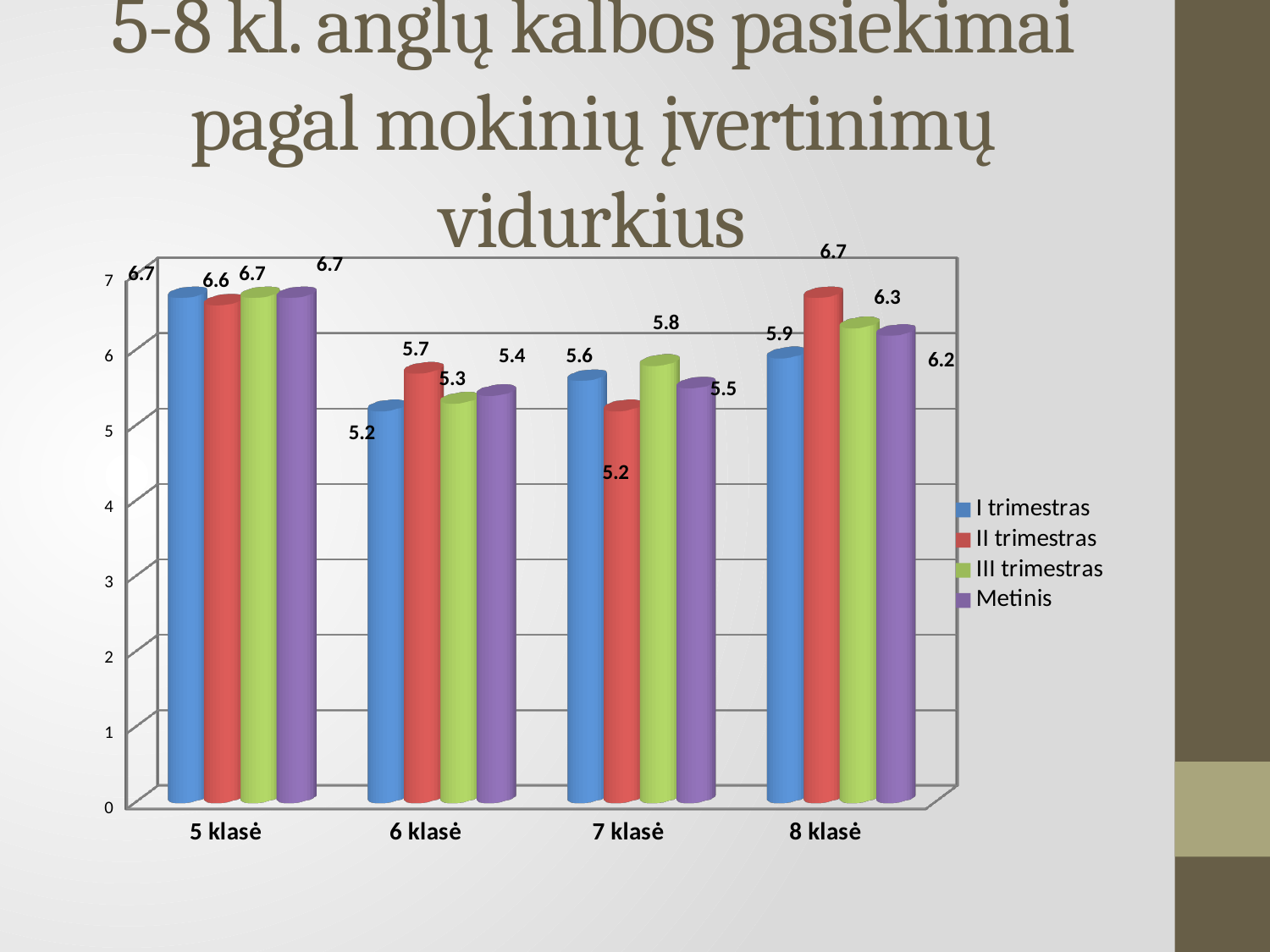
How many classes (categories) are shown on the x axis? 4 What is the difference between the II trimestras values for 8 klasė and 7 klasė? 1.5 What is the value for III trimestras in 7 klasė? 5.8 How many series does the legend list? 4 What kind of chart is shown on the slide? Bar chart Which series is shown in red in the legend? II trimestras What is the value for I trimestras in 5 klasė? 6.7 Which class has the lowest I trimestras value? 6 klasė What is the Metinis value for 8 klasė? 6.2 Which class has the highest Metinis value? 5 klasė Which is larger, the III trimestras value for 6 klasė or for 7 klasė? 7 klasė What is the value for II trimestras in 6 klasė? 5.7